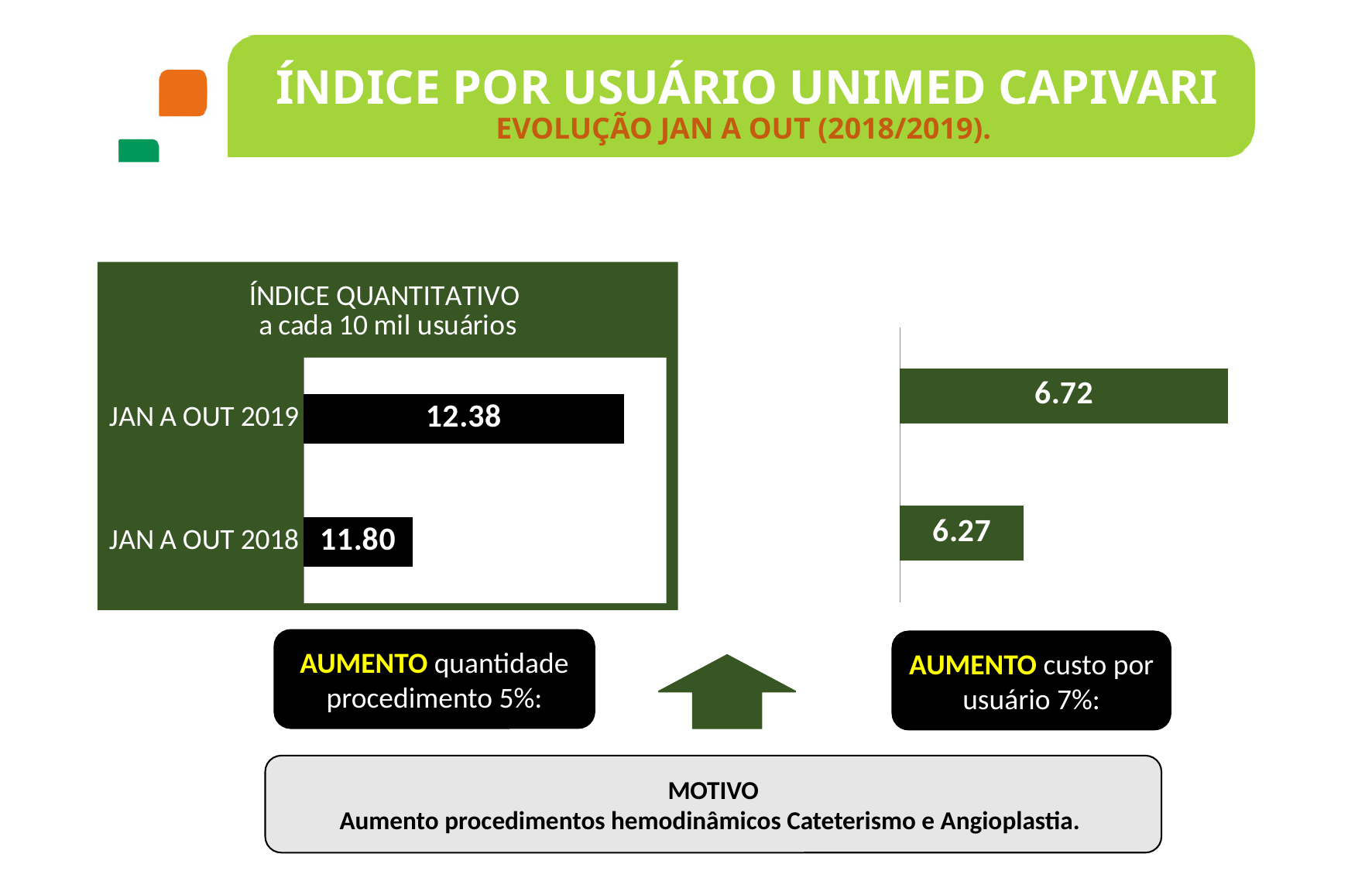
In the left chart titled 'ÍNDICE QUANTITATIVO a cada 10 mil usuários', what is the value for JAN A OUT 2018? 11.80 In the right-hand chart with green bars, what is the difference between the top bar and the bottom bar values? 0.45 In the left chart titled 'ÍNDICE QUANTITATIVO', which period has the higher value? JAN A OUT 2019 In the right-hand chart with green bars, what is the value shown on the bottom bar? 6.27 In the left chart titled 'ÍNDICE QUANTITATIVO a cada 10 mil usuários', what is the value for JAN A OUT 2019? 12.38 What colour are the bars in the left chart titled 'ÍNDICE QUANTITATIVO'? Black In the right-hand chart with green bars, what is the value shown on the top bar? 6.72 In the left chart titled 'ÍNDICE QUANTITATIVO', what is the difference between the JAN A OUT 2019 and JAN A OUT 2018 values? 0.58 In the right-hand chart with green bars, is the top bar or the bottom bar larger? Top bar In the left chart titled 'ÍNDICE QUANTITATIVO', how many categories are shown? 2 What type of chart is the left chart titled 'ÍNDICE QUANTITATIVO'? Bar chart In the left chart titled 'ÍNDICE QUANTITATIVO', which period has the lower value? JAN A OUT 2018